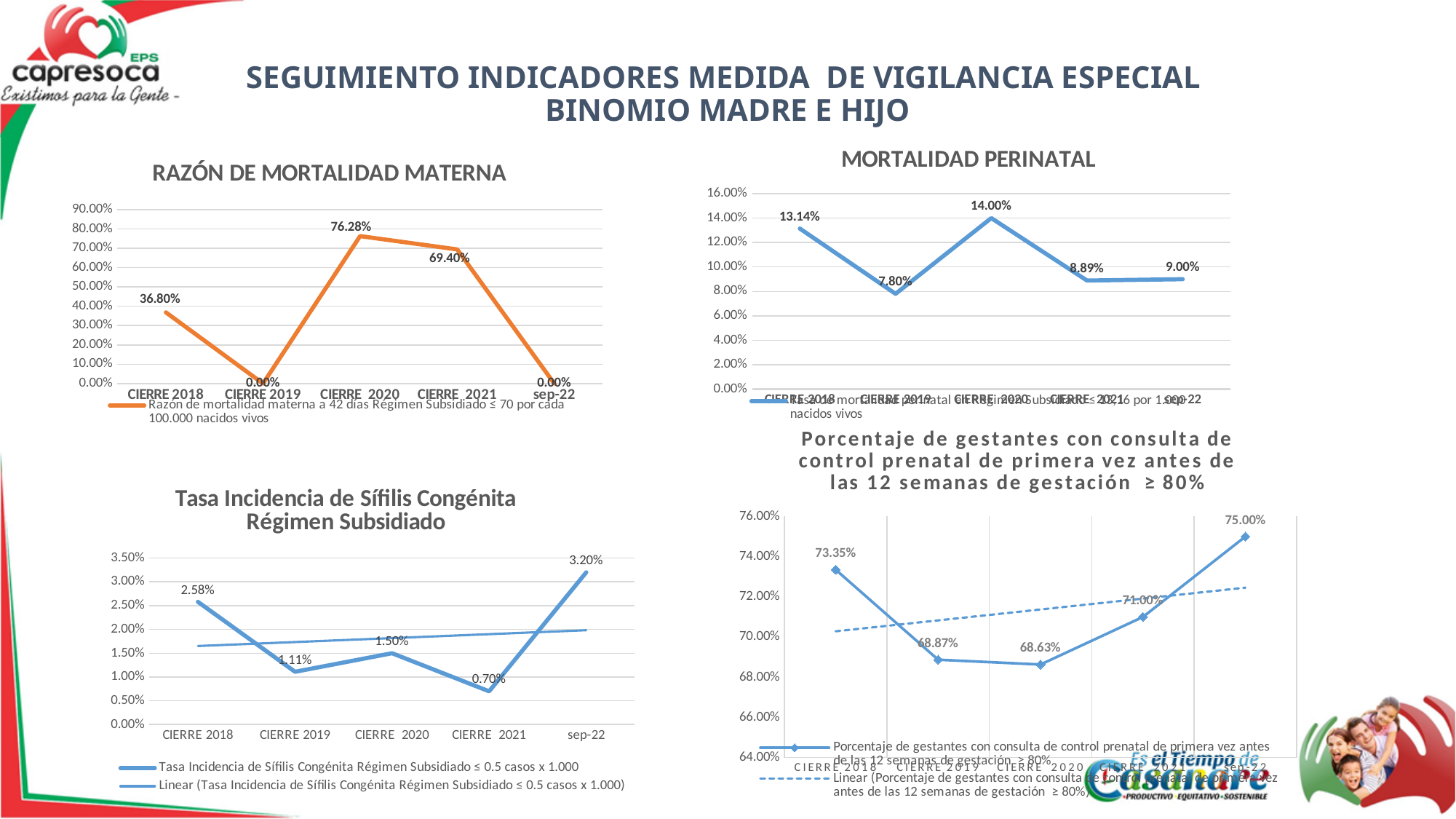
In the MORTALIDAD PERINATAL chart, which period has the highest value? CIERRE 2020 In the MORTALIDAD PERINATAL chart, which is larger, the value for CIERRE 2018 or the value for sep-22? CIERRE 2018 In the RAZÓN DE MORTALIDAD MATERNA chart, what is the difference between the CIERRE 2020 and CIERRE 2021 values? 6.88% In the Porcentaje de gestantes con consulta de control prenatal chart, what is the value for CIERRE 2019? 68.87% In the RAZÓN DE MORTALIDAD MATERNA chart, what is the value for CIERRE 2020? 76.28% In the Tasa Incidencia de Sífilis Congénita Régimen Subsidiado chart, what is the value for sep-22? 3.20% In the Tasa Incidencia de Sífilis Congénita Régimen Subsidiado chart, which period has the lowest value? CIERRE 2021 How many entries does the legend of the Tasa Incidencia de Sífilis Congénita Régimen Subsidiado chart list? 2 What type of chart is the MORTALIDAD PERINATAL chart? Line chart In the Porcentaje de gestantes con consulta de control prenatal chart, what is the difference between the sep-22 and CIERRE 2018 values? 1.65% In the RAZÓN DE MORTALIDAD MATERNA chart, what is the value for CIERRE 2018? 36.80% In the MORTALIDAD PERINATAL chart, what is the value for CIERRE 2019? 7.80%